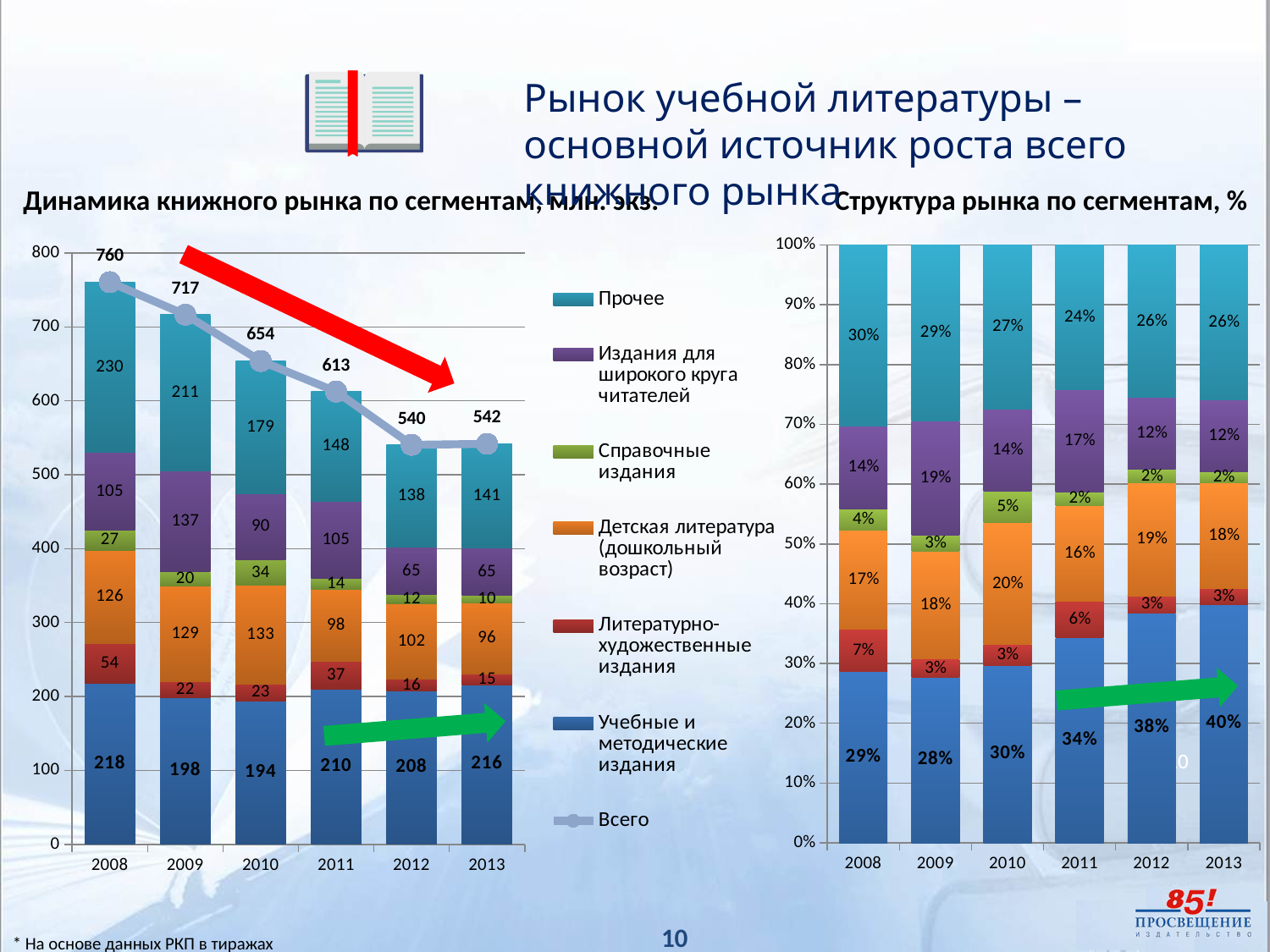
In the left chart 'Динамика книжного рынка по сегментам, млн. экз.', what is the value of 'Прочее' in 2010? 179 In the left chart 'Динамика книжного рынка по сегментам, млн. экз.', how many entries does the legend list? 7 What type of chart is the right chart 'Структура рынка по сегментам, %'? stacked bar chart In the left chart 'Динамика книжного рынка по сегментам, млн. экз.', what is the total (Всего) value for 2008? 760 In the left chart 'Динамика книжного рынка по сегментам, млн. экз.', what is the value of 'Учебные и методические издания' in 2013? 216 In the right chart 'Структура рынка по сегментам, %', is the share of 'Детская литература (дошкольный возраст)' larger in 2010 or in 2011? 2010 In the right chart 'Структура рынка по сегментам, %', what is the share of 'Учебные и методические издания' in 2013? 40% In the right chart 'Структура рынка по сегментам, %', what is the share of 'Прочее' in 2011? 24% In the left chart 'Динамика книжного рынка по сегментам, млн. экз.', which year has the lowest total (Всего) value? 2012 In the left chart 'Динамика книжного рынка по сегментам, млн. экз.', does the total (Всего) line generally rise or fall from 2008 to 2013? fall In the left chart 'Динамика книжного рынка по сегментам, млн. экз.', what is the difference between the total values for 2008 and 2013? 218 In the right chart 'Структура рынка по сегментам, %', which year has the highest share for 'Учебные и методические издания'? 2013